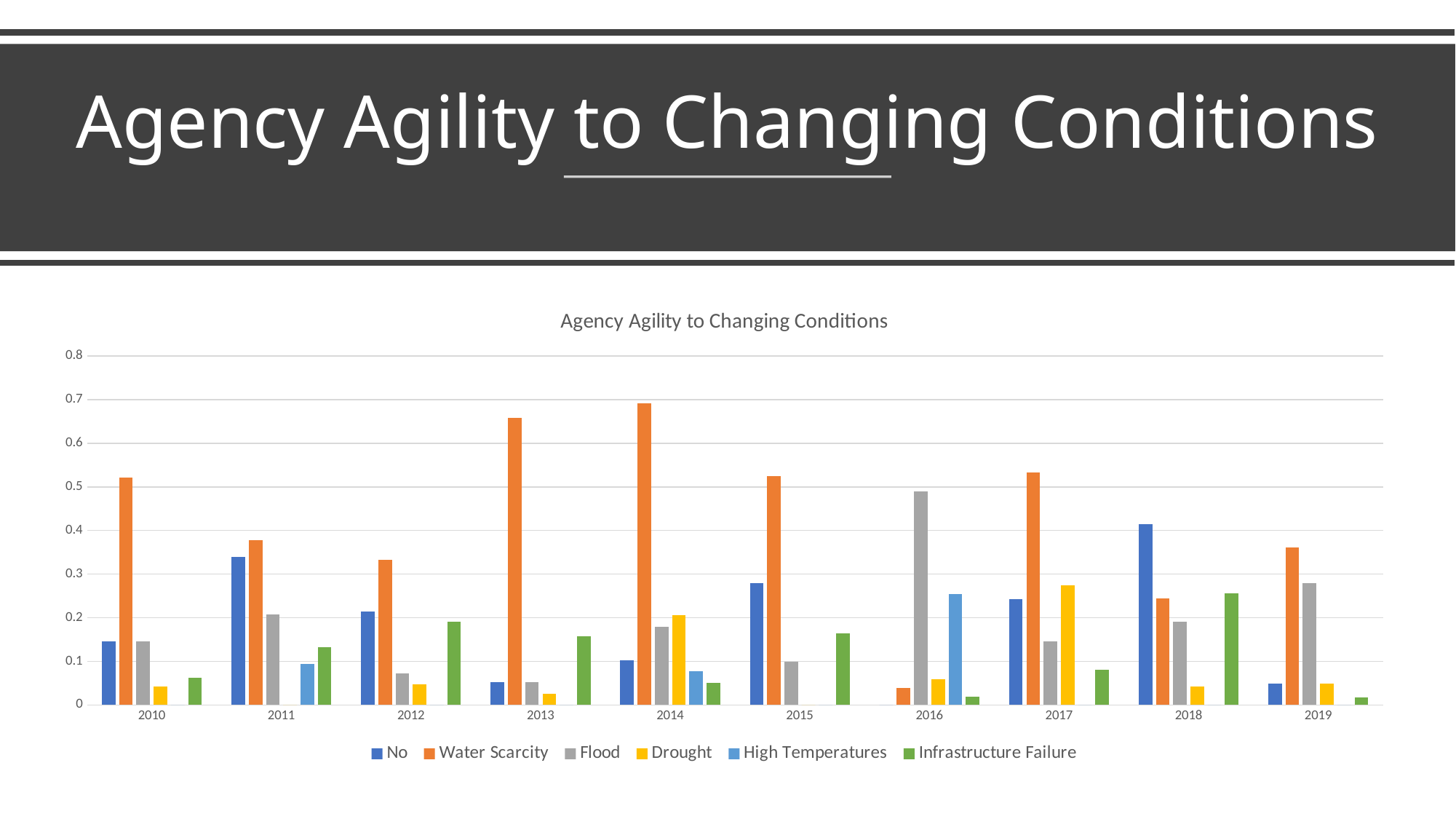
Is the Flood value for 2016 greater or less than 0.4? greater In which year is the Water Scarcity bar the highest? 2014 What colour represents Water Scarcity in the legend? orange In 2018, which is larger: the No bar or the Water Scarcity bar? No In which year is the Water Scarcity bar the lowest? 2016 Is the Water Scarcity value for 2013 greater or less than 0.6? greater Which series has the tallest bar in 2016? Flood How many series does the legend list? 6 How many years are shown along the x axis? 10 In 2017, which is larger: the Drought bar or the Flood bar? Drought What kind of chart is shown on the slide? bar chart Is the No value for 2011 greater or less than 0.3? greater